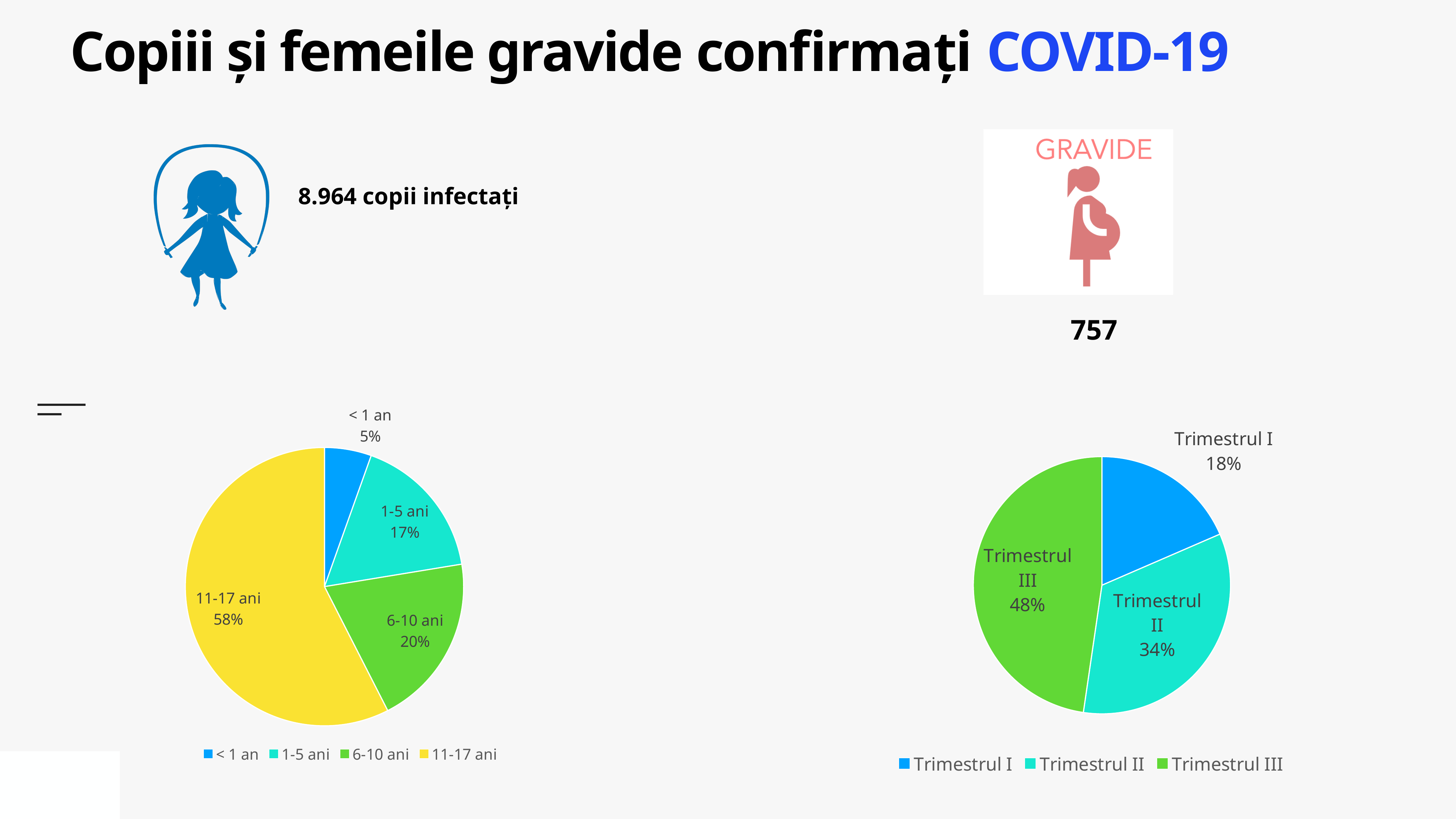
In the left pie chart (children by age group), what share is shown for the < 1 an slice? 5% In the right pie chart (pregnant women by trimester), which trimester has the largest slice? Trimestrul III In the left pie chart (children by age group), what is the difference in percentage points between the 6-10 ani and 1-5 ani slices? 3 In the right pie chart (pregnant women by trimester), how many entries does the legend list? 3 In the right pie chart (pregnant women by trimester), what is the difference in percentage points between Trimestrul III and Trimestrul I? 30 In the right pie chart (pregnant women by trimester), what share is shown for Trimestrul II? 34% In the left pie chart (children by age group), how many slices does the pie have? 4 In the left pie chart (children by age group), which age group has the largest slice? 11-17 ani In the right pie chart (pregnant women by trimester), which trimester has the smallest slice? Trimestrul I In the left pie chart (children by age group), which age group has the smallest slice? < 1 an What kind of chart is the right chart (pregnant women by trimester)? Pie chart In the left pie chart (children by age group), what share is shown for the 11-17 ani slice? 58%